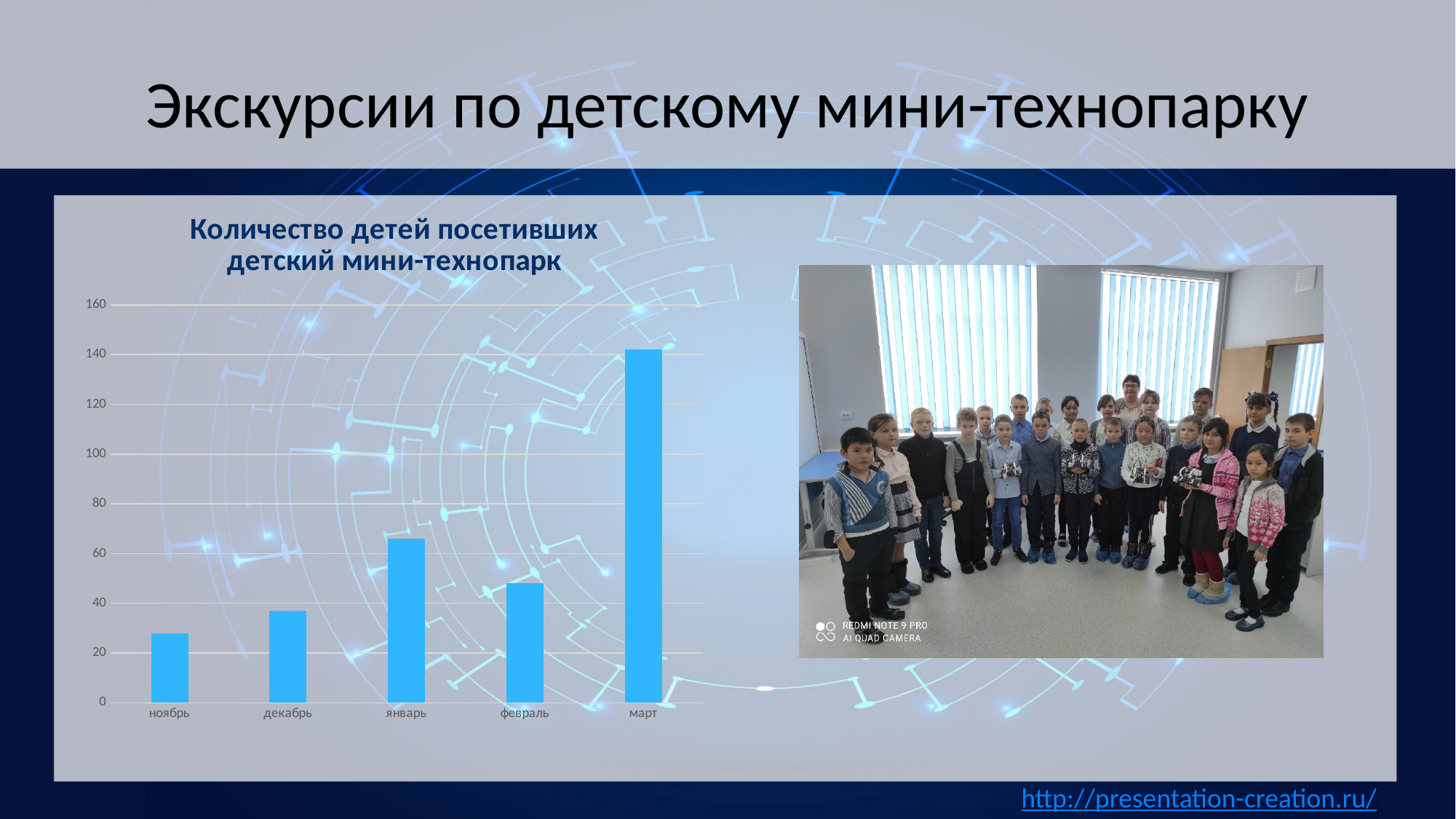
Does the value rise or fall from январь to февраль? fall Which is larger, the value for январь or the value for февраль? январь Is the value for февраль greater or less than 40? greater Is the value for ноябрь greater or less than 40? less Which month has the lowest value in the chart? ноябрь Which month has the highest value in the chart? март Is the value for март greater or less than 160? less What is the title of the chart? Количество детей посетивших детский мини-технопарк What kind of chart is shown on the slide? bar chart How many months (categories) are shown on the x axis of the chart? 5